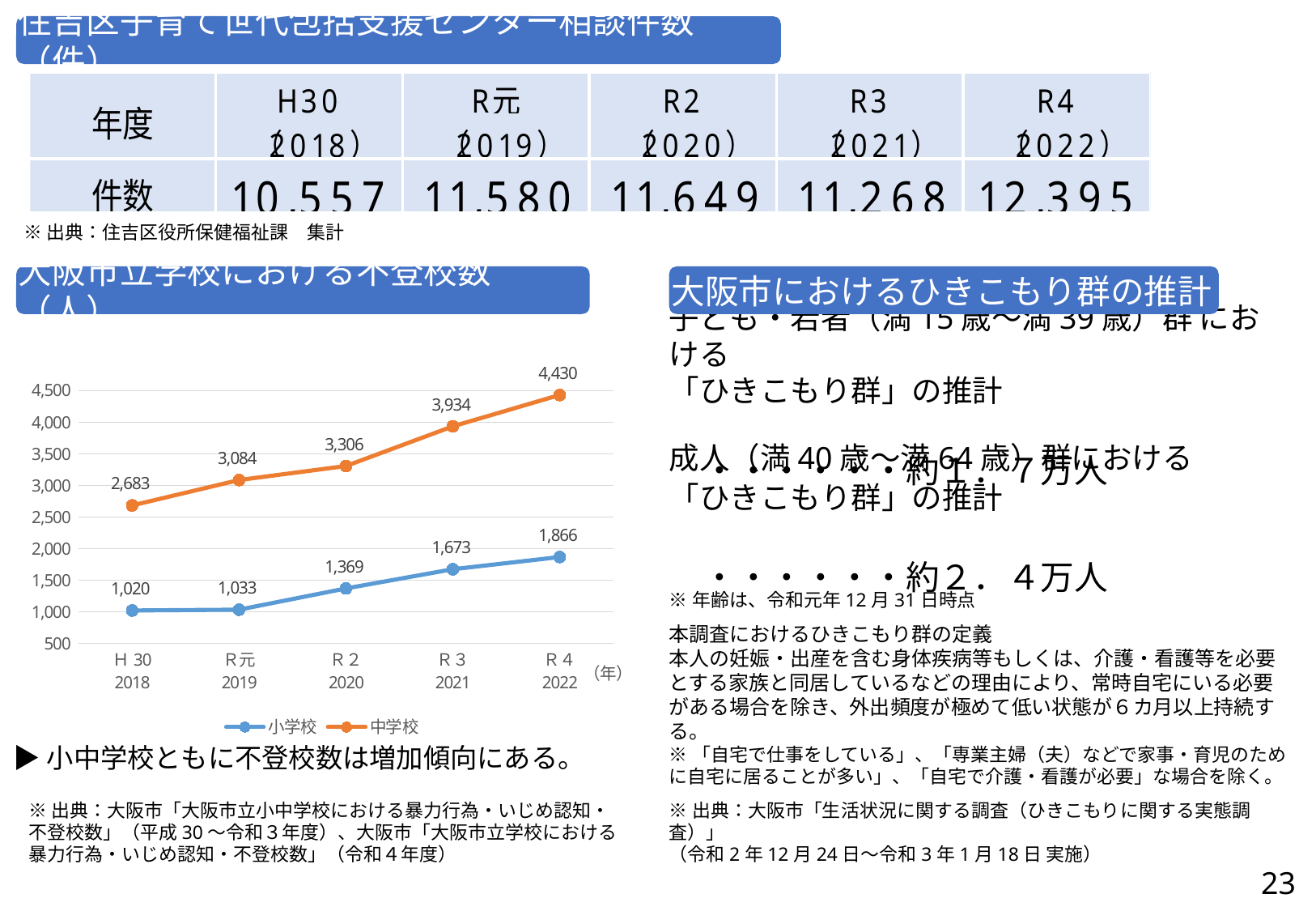
By how much did the 小学校 value increase from H30 (2018) to R4 (2022) on the 不登校数 line chart? 846 What type of chart is used to show the number of non-attending students (不登校数) in Osaka municipal schools? line chart How many series does the legend of the 不登校数 line chart list? 2 What is the value for 中学校 in R2 (2020) on the 不登校数 line chart? 3,306 How many years (data points per series) are plotted on the 不登校数 line chart? 5 In which year does the 小学校 series reach its highest value on the 不登校数 line chart? R4 (2022) What is the value for 小学校 in H30 (2018) on the 不登校数 line chart? 1,020 Does the 中学校 series rise or fall from H30 (2018) to R4 (2022) on the 不登校数 line chart? rise What is the value for 中学校 in R4 (2022) on the 不登校数 line chart? 4,430 What is the difference between the 中学校 and 小学校 values in R4 (2022) on the 不登校数 line chart? 2,564 Which series has the larger value in R3 (2021) on the 不登校数 line chart, 小学校 or 中学校? 中学校 In which year is the 中学校 series lowest on the 不登校数 line chart? H30 (2018)